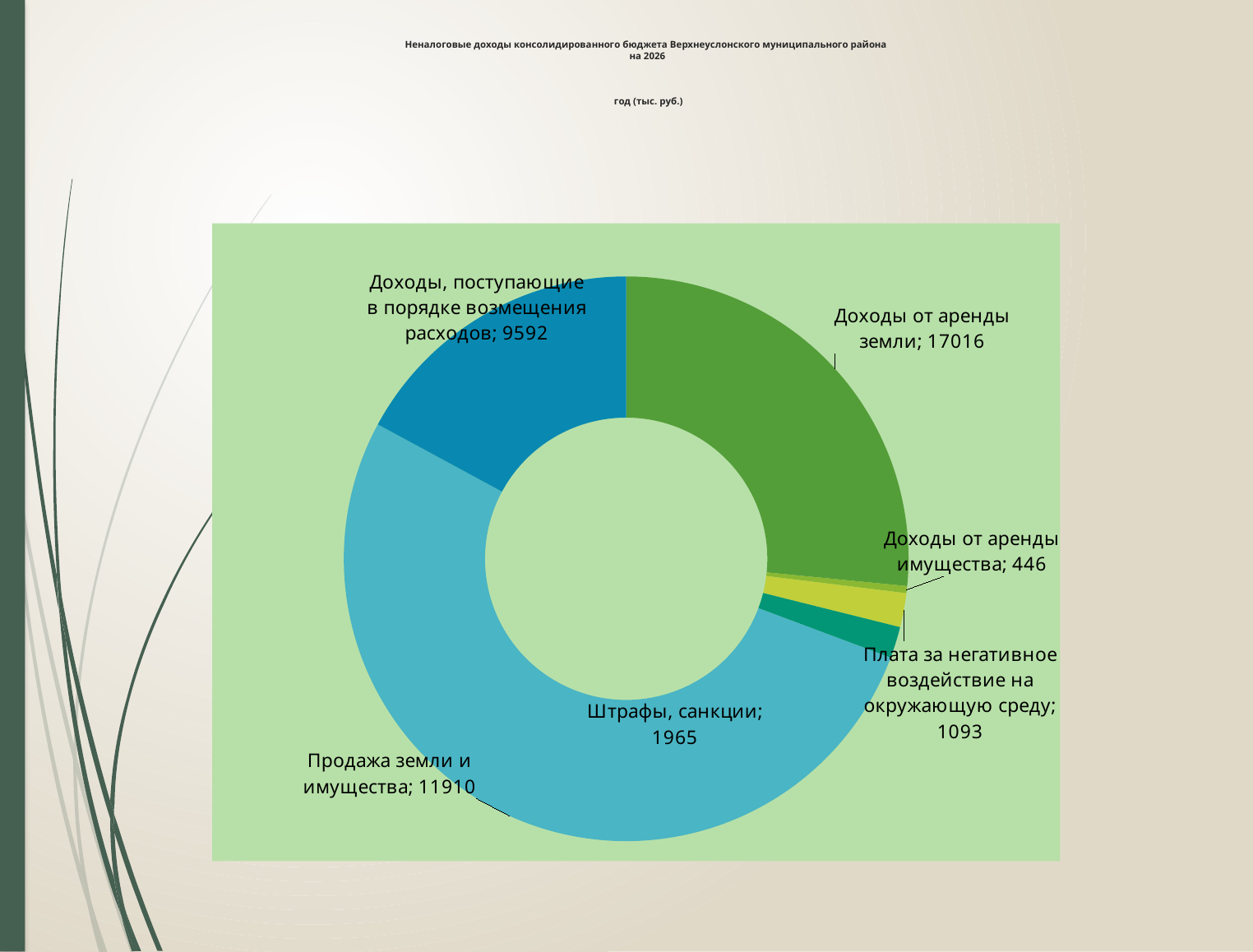
What is the value for Доходы от аренды земли? 17016 What type of chart is shown on the slide? doughnut chart What is the value for Плата за негативное воздействие на окружающую среду? 1093 What is the value for Доходы, поступающие в порядке возмещения расходов? 9592 What is the difference between Доходы от аренды земли and Продажа земли и имущества? 5106 What is the total of all categories shown in the chart? 42022 Which is larger: Продажа земли и имущества or Доходы, поступающие в порядке возмещения расходов? Продажа земли и имущества What is the value for Продажа земли и имущества? 11910 Which category has the lowest value? Доходы от аренды имущества How many categories does the chart show? 6 What is the difference between Штрафы, санкции and Плата за негативное воздействие на окружающую среду? 872